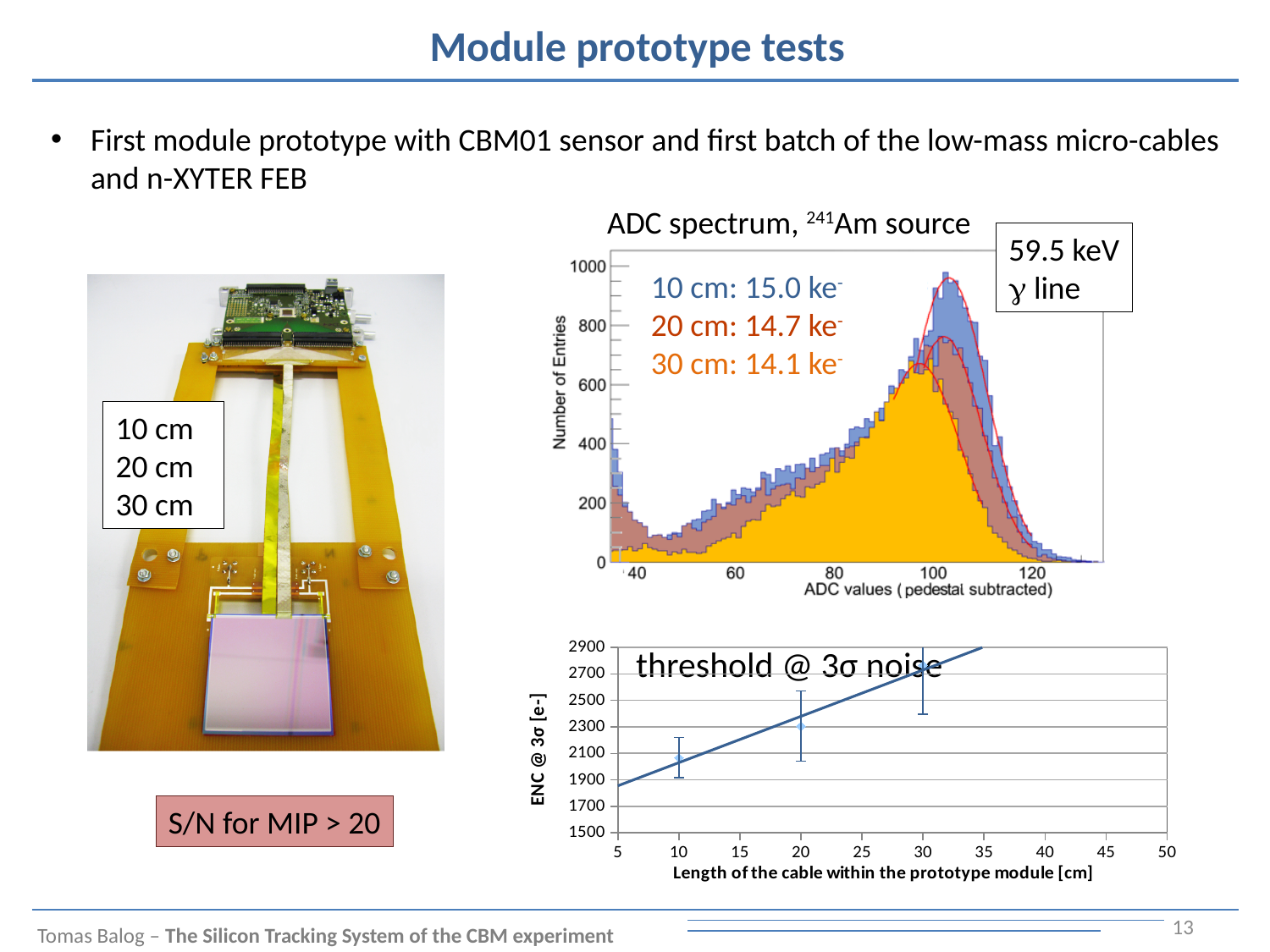
In the bottom-right ENC chart, is the ENC value at 10 cm greater or less than 1900? greater In the ADC spectrum chart, what signal value is given for the 20 cm cable? 14.7 ke- In the bottom-right ENC chart, is the ENC value at 30 cm greater or less than 2500? greater In the bottom-right ENC chart, how many data points are plotted? 3 In the bottom-right ENC chart, what is the label of the x axis? Length of the cable within the prototype module [cm] In the bottom-right ENC chart, does the ENC rise or fall as the cable length increases? Rises In the bottom-right ENC chart, what is the maximum value shown on the y axis? 2900 In the bottom-right ENC chart, is the ENC value at 20 cm greater or less than 2100? greater What kind of chart is the bottom-right chart of ENC versus cable length? Scatter chart with a trend line In the ADC spectrum chart, which cable length gives the largest signal? 10 cm In the bottom-right ENC chart, which cable length has the highest ENC? 30 cm In the bottom-right ENC chart, which cable length has the lowest ENC? 10 cm